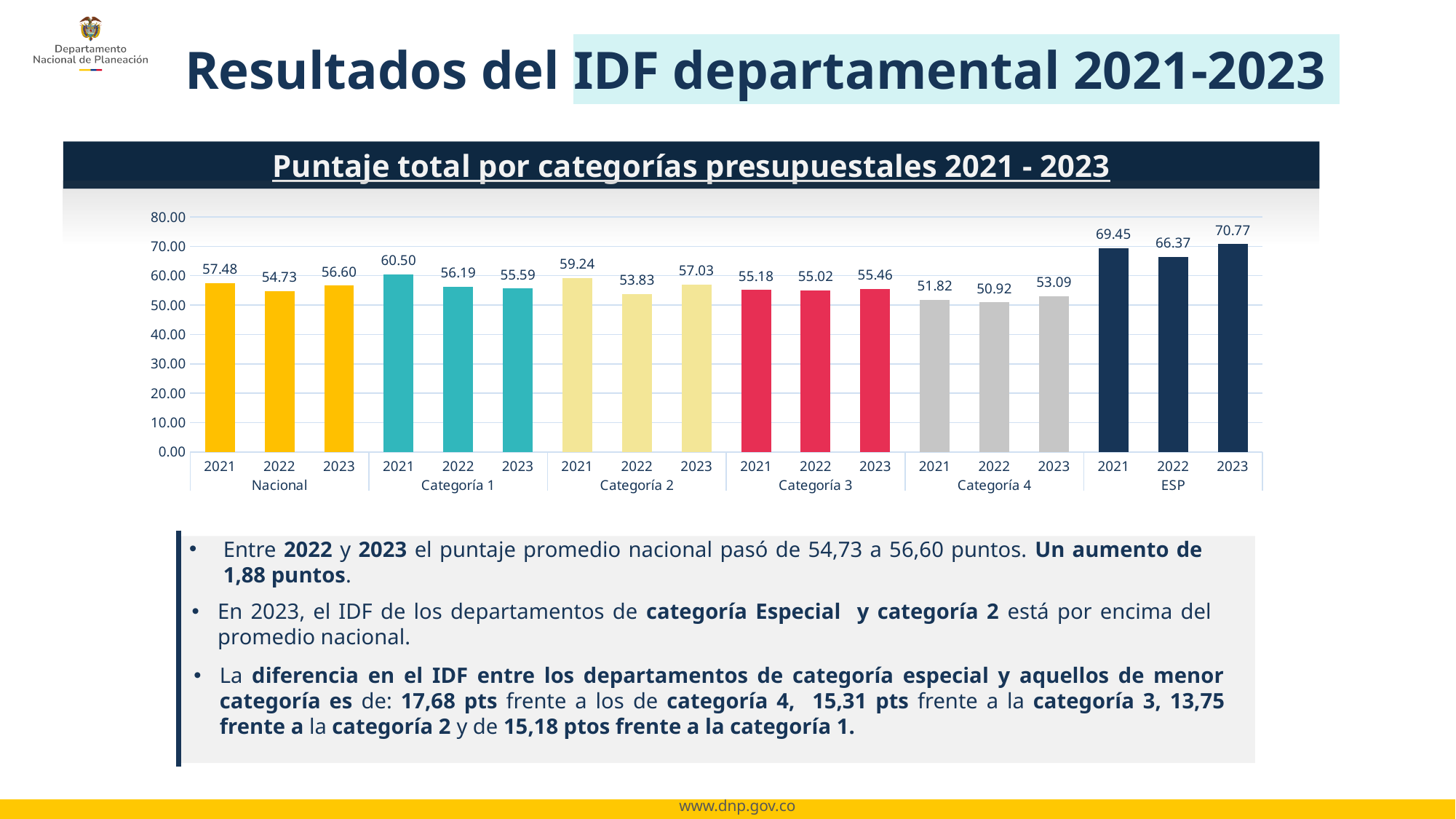
Do the values for Categoría 1 rise or fall from 2021 to 2023? fall What is the value for Categoría 3 in 2022? 55.02 Which bar has the highest value in the chart? ESP 2023 (70.77) What kind of chart is shown on the slide? bar chart Which is larger in 2021: Categoría 1 or Categoría 2? Categoría 1 What is the difference between the 2023 values for ESP and Categoría 4? 17.68 What is the title of the chart? Puntaje total por categorías presupuestales 2021 - 2023 Which bar has the lowest value in the chart? Categoría 4 2022 (50.92) Is the value for Categoría 4 in 2022 greater or less than 60? less What is the value for Nacional in 2023? 56.60 How many category groups are shown on the x axis? 6 What is the value for ESP in 2021? 69.45